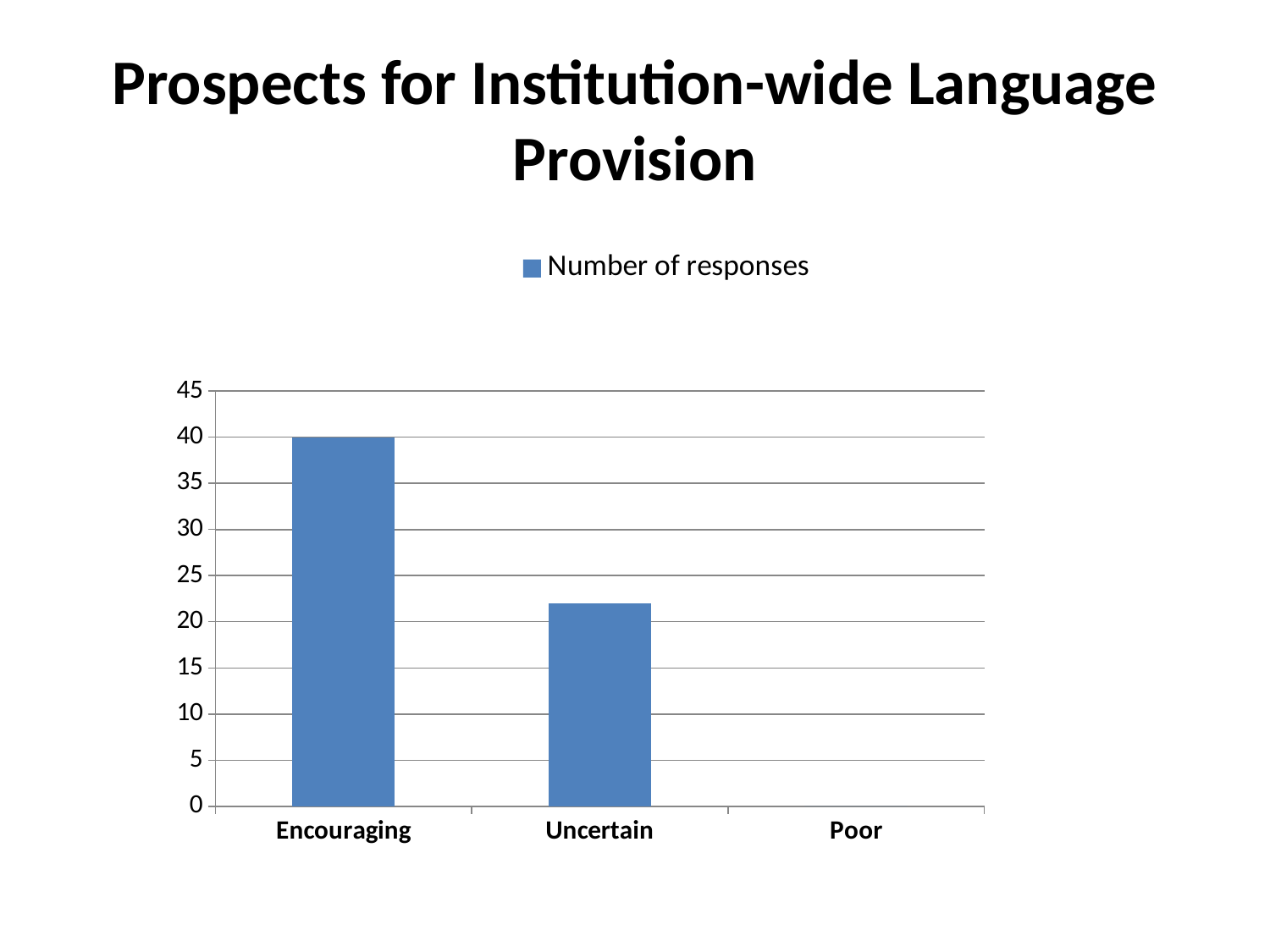
What series name is shown in the chart's legend? Number of responses How many series does the chart's legend list? 1 What kind of chart is shown on the slide? bar chart What is the number of responses for Encouraging? 40 Which has more responses, Encouraging or Uncertain? Encouraging Which category has the highest number of responses? Encouraging Is the value for Uncertain greater or less than 20? greater How many categories are shown on the x axis of the chart? 3 What is the number of responses for Poor? 0 Which category has the lowest number of responses? Poor What is the title of the slide containing the chart? Prospects for Institution-wide Language Provision Is the value for Uncertain greater or less than 25? less